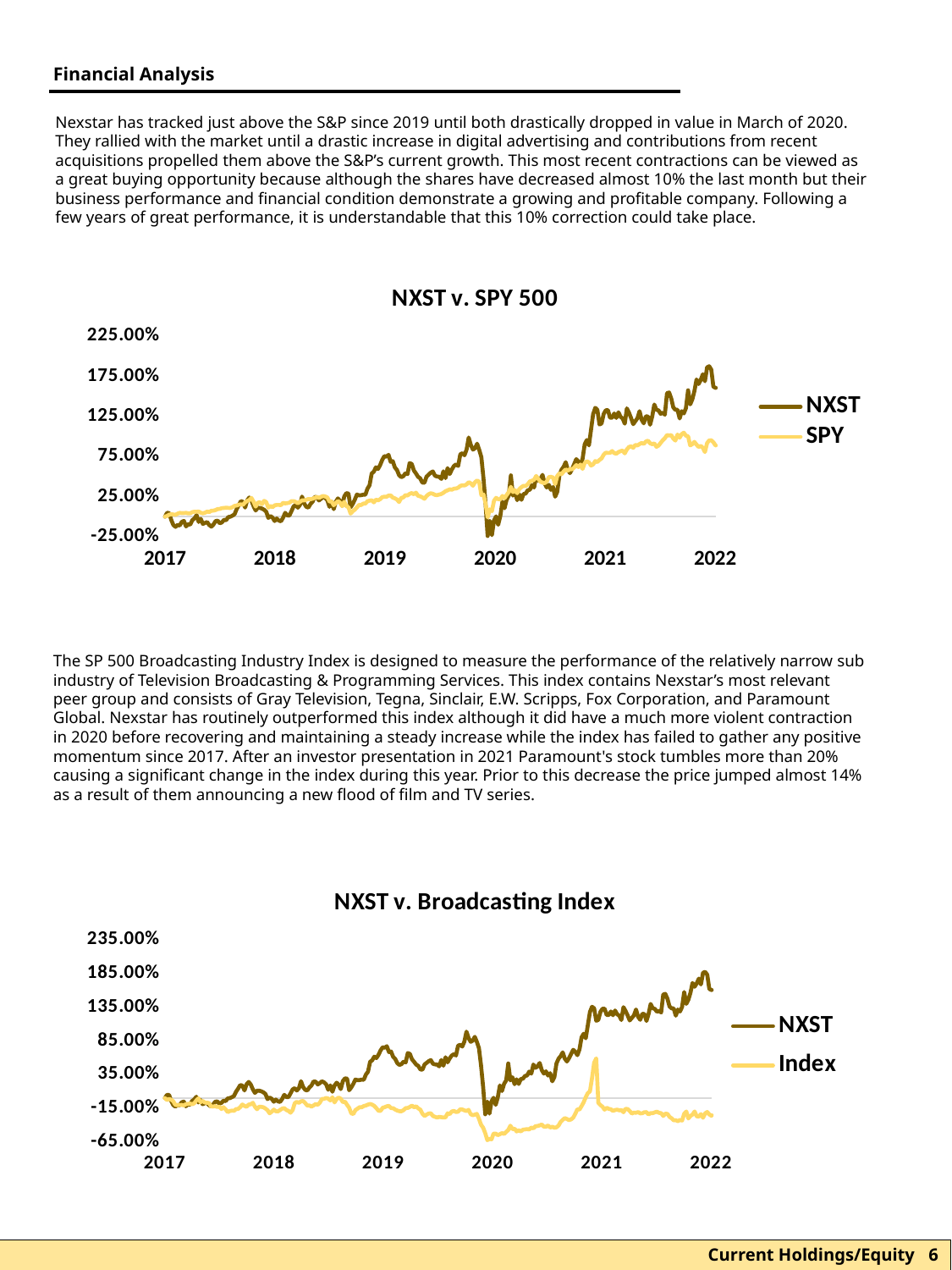
In the chart titled "NXST v. Broadcasting Index", at the 2022 end of the chart, is the NXST value greater or less than 135.00%? greater In the chart titled "NXST v. Broadcasting Index", at the 2022 end of the chart, is the Index value greater or less than 35.00%? less In the chart titled "NXST v. SPY 500", at the 2022 end of the chart, is the NXST value greater or less than 125.00%? greater In the chart titled "NXST v. Broadcasting Index", how many series does the legend list? 2 In the chart titled "NXST v. Broadcasting Index", at the 2022 end of the chart, which series is higher, NXST or Index? NXST In the chart titled "NXST v. SPY 500", how many years are labelled on the x axis? 6 In the chart titled "NXST v. SPY 500", at the 2022 end of the chart, which series is higher, NXST or SPY? NXST In the chart titled "NXST v. SPY 500", which two series are listed in the legend? NXST and SPY In the chart titled "NXST v. SPY 500", what kind of chart is shown? line chart In the chart titled "NXST v. SPY 500", does the NXST line overall rise or fall from 2017 to 2022? rise In the chart titled "NXST v. SPY 500", how many series does the legend list? 2